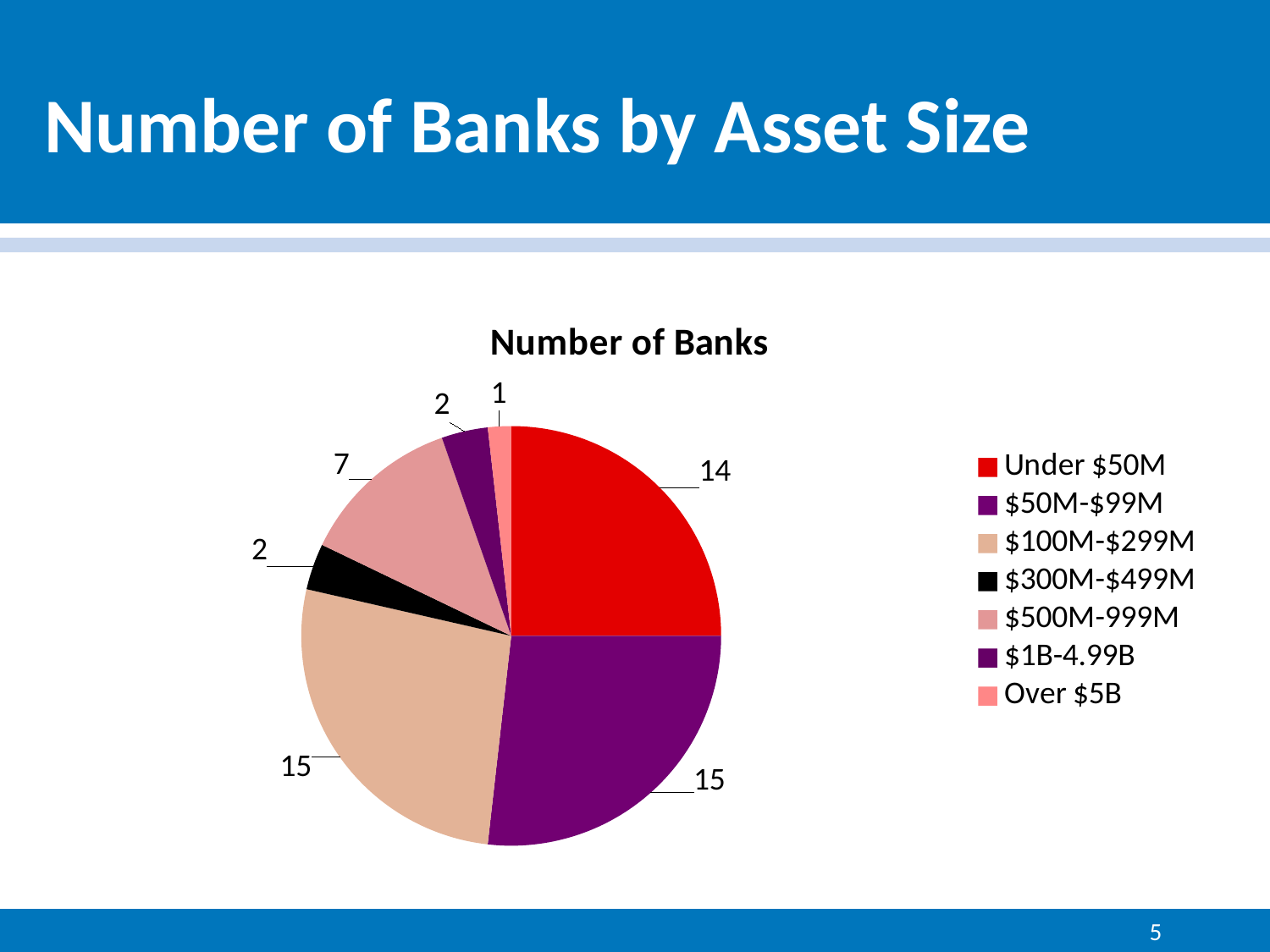
What is the number of banks in the Under $50M category? 14 What is the title of the chart? Number of Banks Which asset size category has the fewest banks? Over $5B What is the value for the Over $5B slice? 1 What is the difference between the number of banks in the $50M-$99M category and the $500M-999M category? 8 How many banks are in the $300M-$499M category? 2 What kind of chart is shown on the slide? Pie chart How many categories does the pie chart show? 7 How many banks are in the $500M-999M category? 7 Which has more banks, Under $50M or $500M-999M? Under $50M What is the total number of banks across all slices of the pie chart? 56 What share of the total number of banks does the Under $50M slice represent? 25%